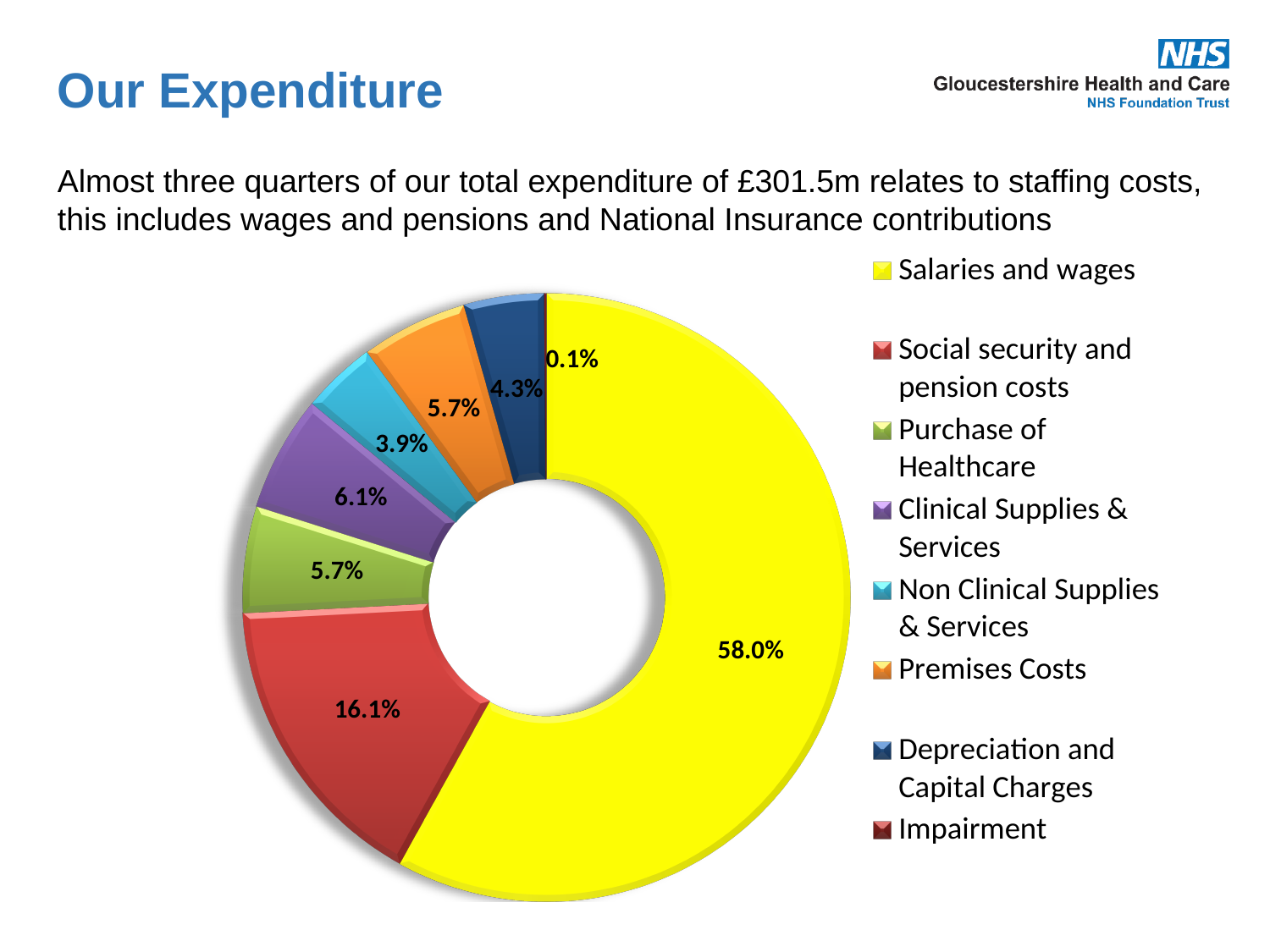
What percentage of expenditure is Salaries and wages? 58.0% Which category has the smallest share of expenditure? Impairment What percentage of expenditure is Depreciation and Capital Charges? 4.3% What percentage of expenditure is Social security and pension costs? 16.1% What kind of chart is shown on the slide? Doughnut (pie) chart How many categories does the legend list? 8 Which category has the largest share of expenditure? Salaries and wages What percentage of expenditure is Non Clinical Supplies & Services? 3.9% Which is larger, the share for Clinical Supplies & Services or the share for Non Clinical Supplies & Services? Clinical Supplies & Services What percentage of expenditure is Clinical Supplies & Services? 6.1% What is the difference in percentage points between Salaries and wages and Social security and pension costs? 41.9 What colour is the Salaries and wages segment? Yellow